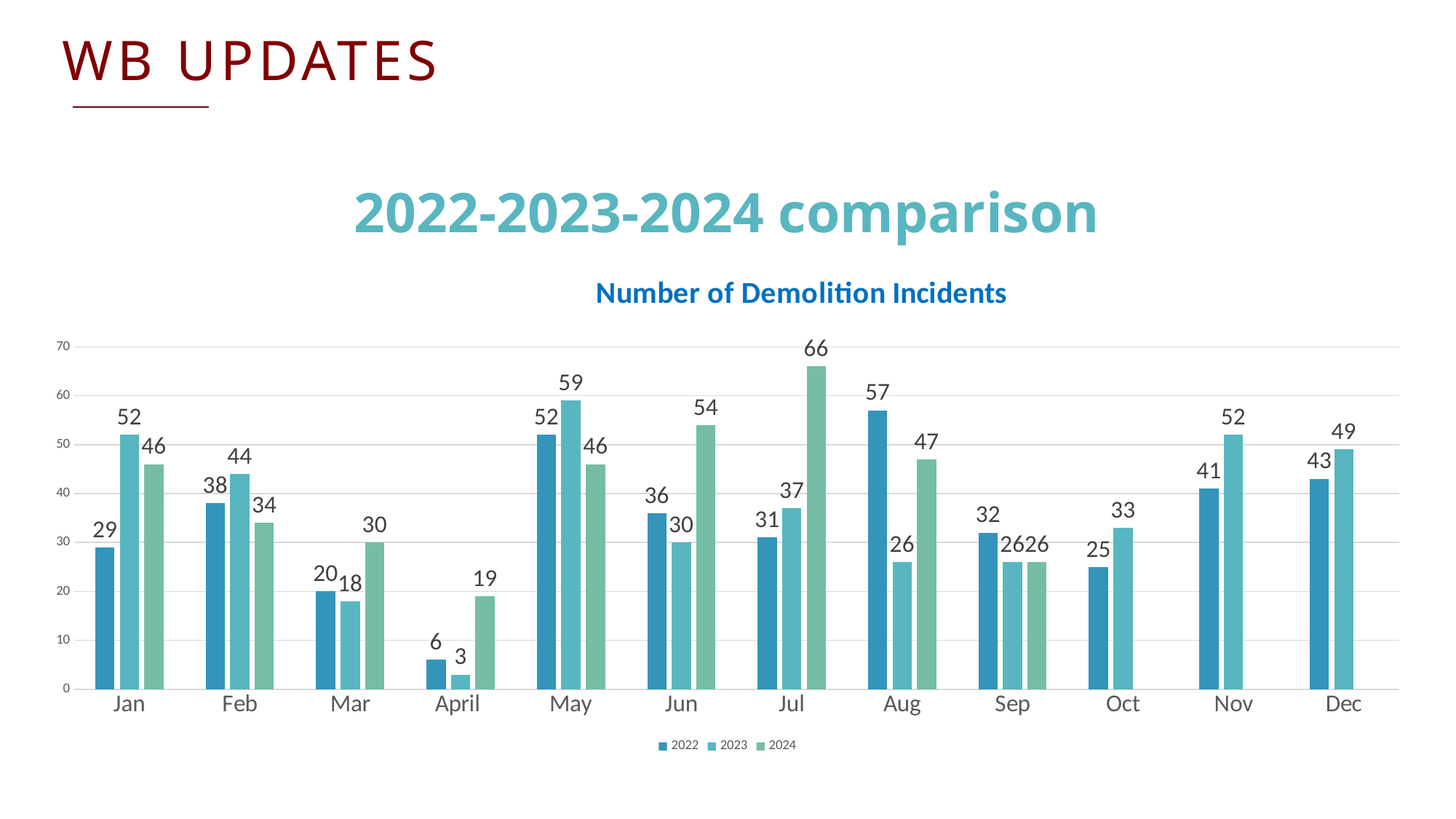
What is the number of demolition incidents for 2024 in Jul? 66 What is the difference between the 2024 and 2022 values in Jul? 35 What kind of chart is shown on the slide? Bar chart How many months are shown on the x axis? 12 What is the title of the chart? Number of Demolition Incidents Which month has the lowest value for the 2022 series? April What is the number of demolition incidents for 2023 in April? 3 Which month has the highest value for the 2023 series? May Which months have no bar for the 2024 series? Oct, Nov, Dec What is the number of demolition incidents for 2022 in Aug? 57 Which is larger in Jun: the 2022 value or the 2023 value? 2022 How many series does the legend list? 3